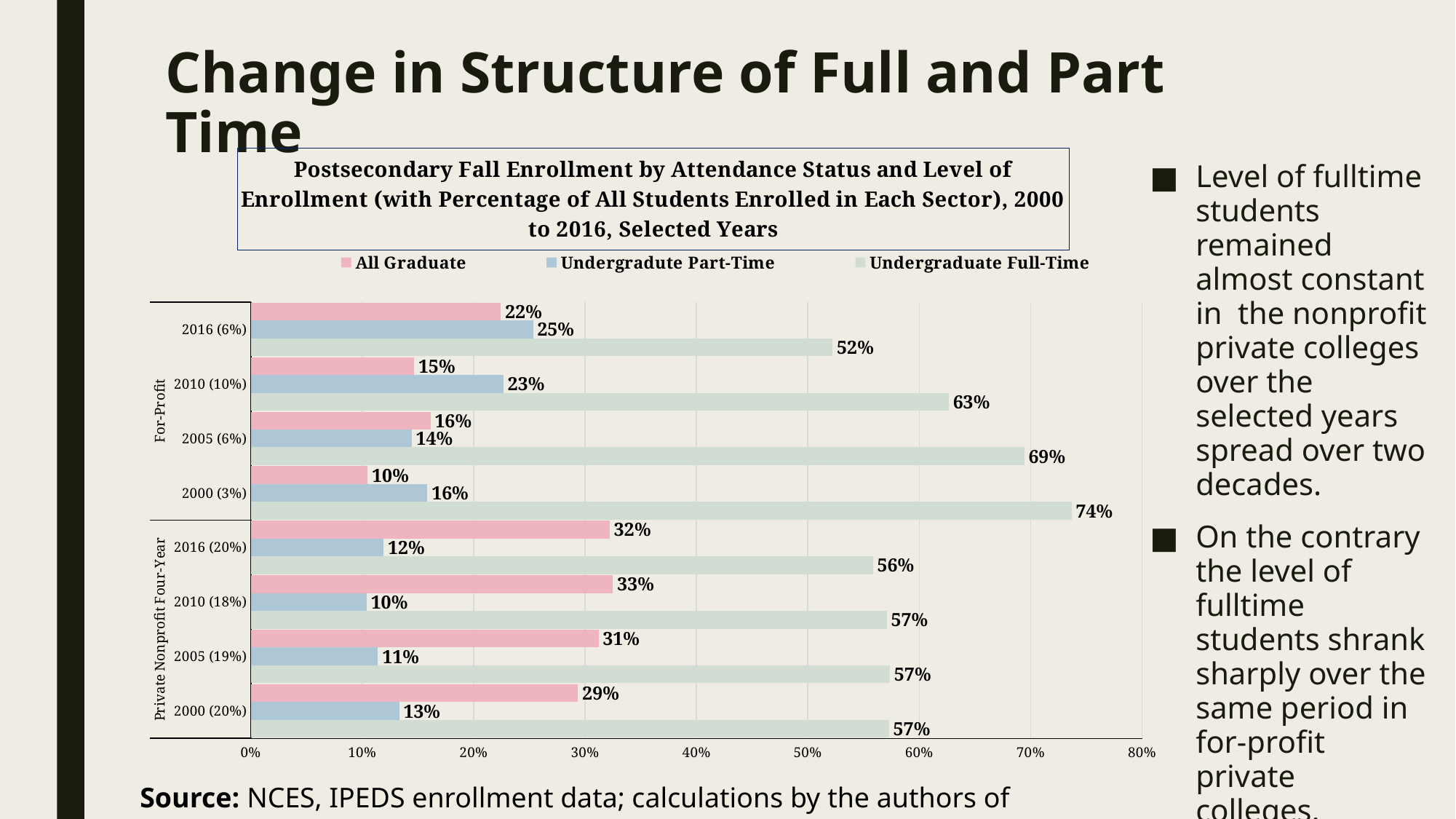
Which colour represents the Undergraduate Full-Time series in the legend? Light green What is the Undergraduate Full-Time value for For-Profit 2000 (3%)? 74% Which category has the lowest Undergraduate Part-Time value? Private Nonprofit Four-Year 2010 (18%) What is the All Graduate value for Private Nonprofit Four-Year 2010 (18%)? 33% How many series does the chart legend list? 3 How many year categories are plotted on the chart in total? 8 Which is larger: the All Graduate value for For-Profit 2016 (6%) or for Private Nonprofit Four-Year 2016 (20%)? Private Nonprofit Four-Year 2016 (20%) Which category has the highest Undergraduate Full-Time value? For-Profit 2000 (3%) What is the Undergraduate Part-Time value for For-Profit 2016 (6%)? 25% Do the Undergraduate Full-Time values for the For-Profit sector rise or fall from 2000 to 2016? Fall What kind of chart is shown on the slide? Bar chart What is the difference between the Undergraduate Full-Time values for For-Profit 2000 (3%) and For-Profit 2016 (6%)? 22%